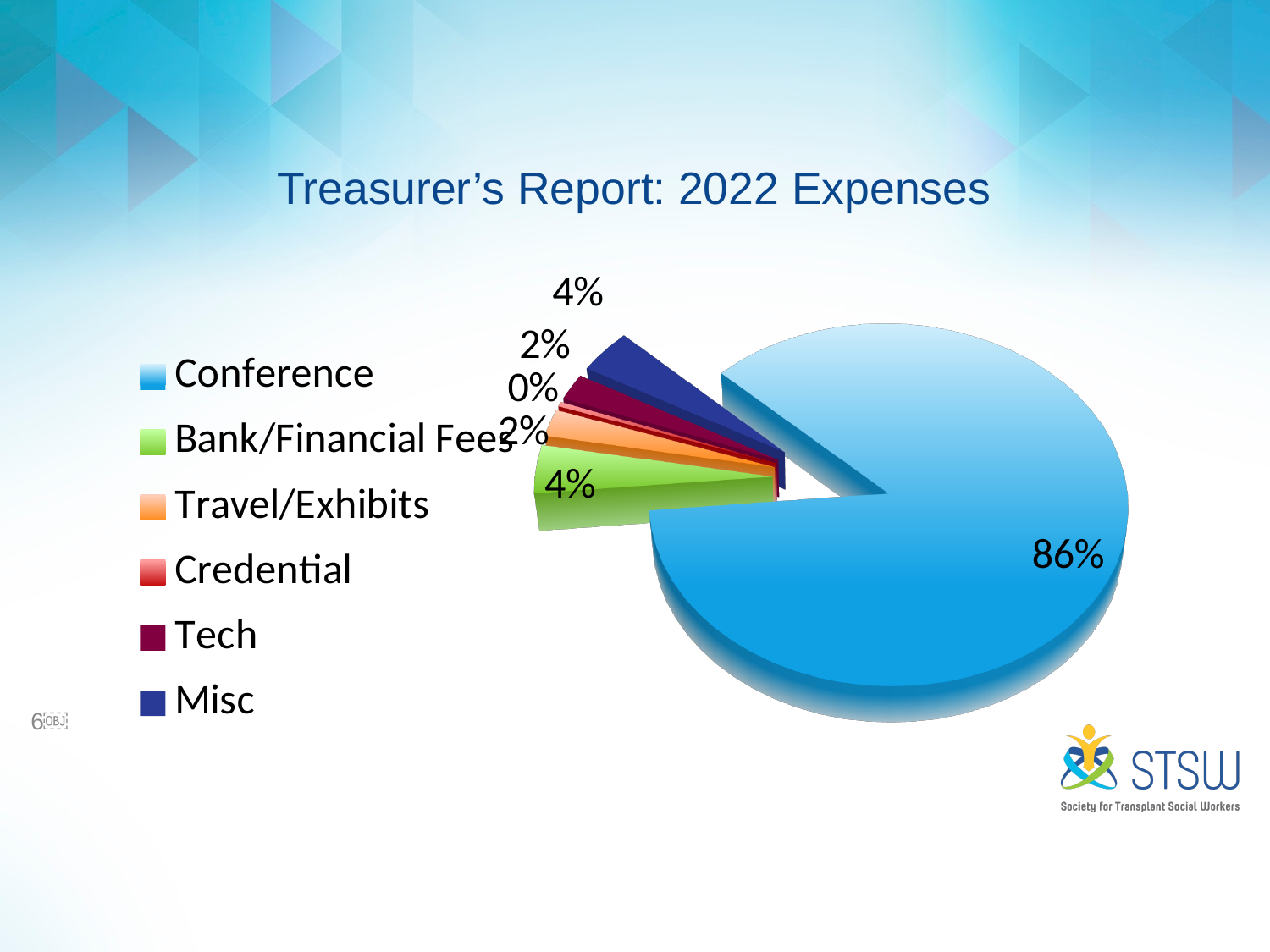
Which is larger, the share for Conference or the share for Misc? Conference How many expense categories are shown in the pie chart? 6 What percentage of expenses is Credential? 0% Which expense category has the smallest share of the pie? Credential What type of chart is shown on the slide? pie chart What percentage of expenses is Tech? 2% What share of 2022 expenses does Conference account for? 86% What percentage of expenses is Misc? 4% What is the difference in percentage points between Conference and Bank/Financial Fees? 82% What is the title of the chart on the slide? Treasurer's Report: 2022 Expenses What percentage of expenses is Bank/Financial Fees? 4% Which expense category has the largest share of the pie? Conference